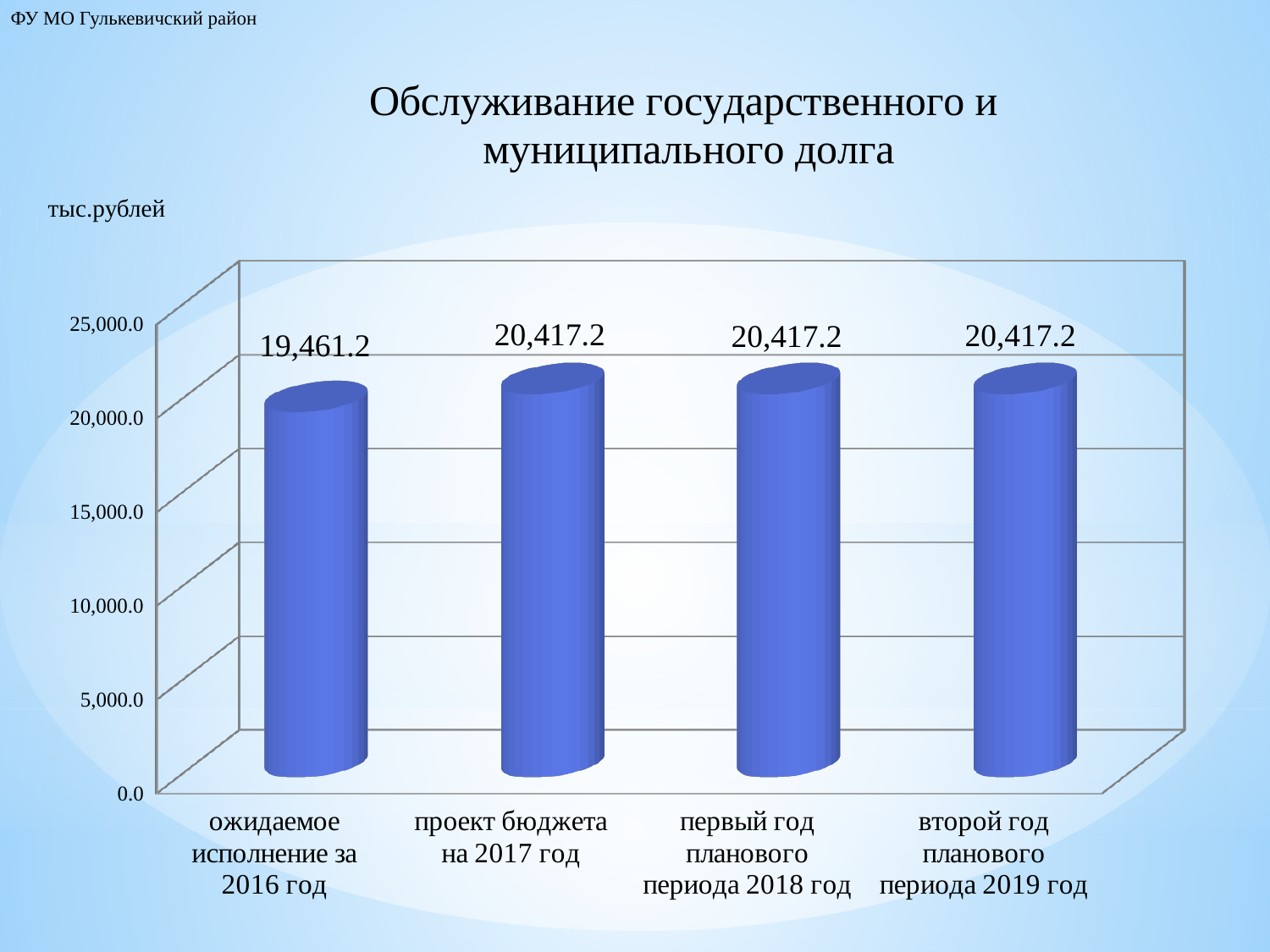
How many categories are shown on the x axis? 4 What is the difference between the value for проект бюджета на 2017 год and the value for ожидаемое исполнение за 2016 год? 956.0 Which is larger: the value for ожидаемое исполнение за 2016 год or the value for проект бюджета на 2017 год? проект бюджета на 2017 год Is the value for ожидаемое исполнение за 2016 год greater or less than 20,000.0? less Do the values rise or fall from 2016 to 2017, and what happens after that? rise, then stay flat What is the value for проект бюджета на 2017 год? 20,417.2 Which category has the lowest value? ожидаемое исполнение за 2016 год What kind of chart is shown on the slide? bar chart What is the value for второй год планового периода 2019 год? 20,417.2 What is the value for ожидаемое исполнение за 2016 год? 19,461.2 What unit of measurement is stated above the chart? тыс.рублей What is the value for первый год планового периода 2018 год? 20,417.2